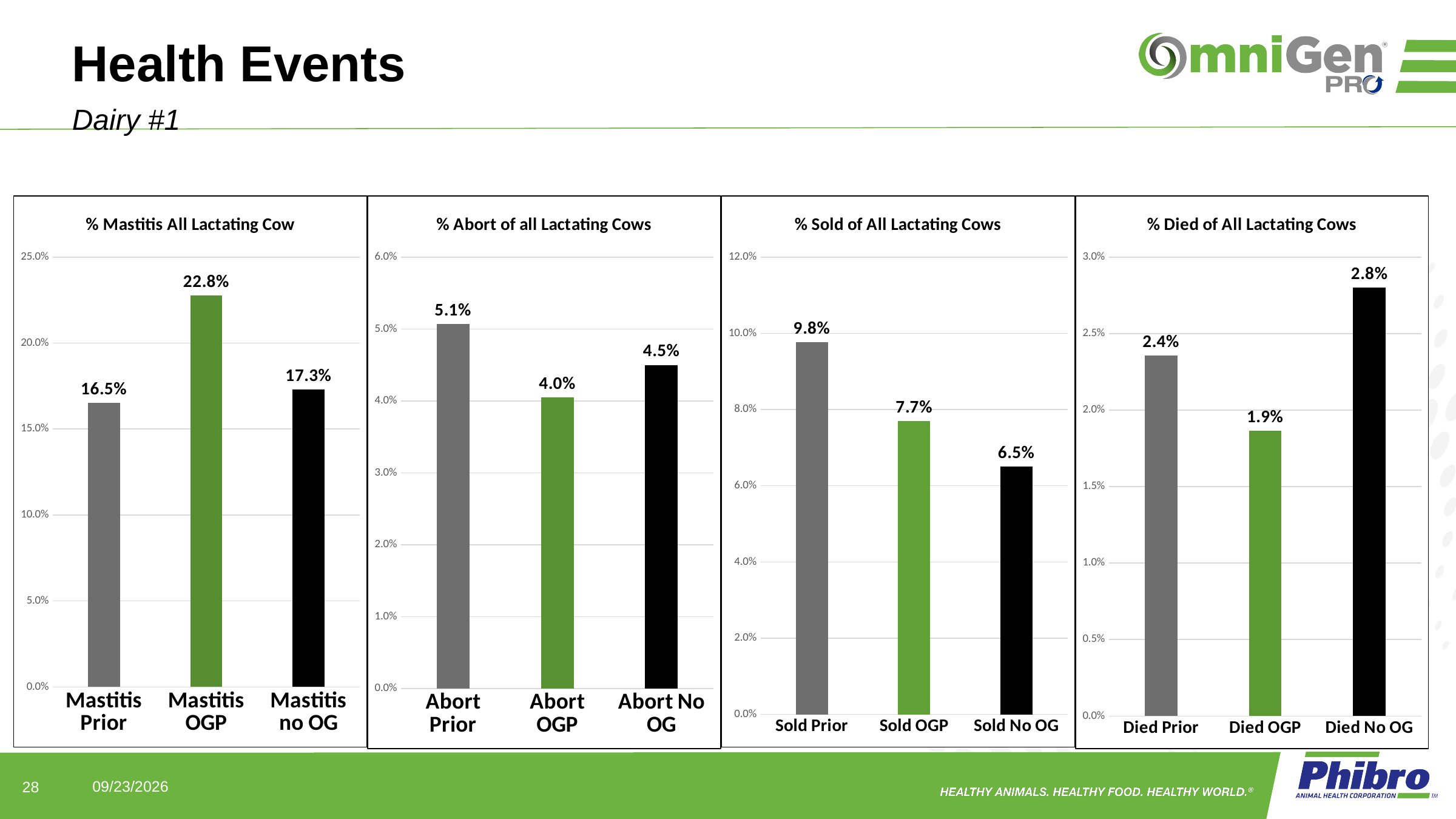
What type of chart is the '% Mastitis All Lactating Cow' chart? bar chart In the '% Abort of all Lactating Cows' chart, which category has the highest value? Abort Prior How many bars are in the '% Died of All Lactating Cows' chart? 3 In the '% Sold of All Lactating Cows' chart, is the value for Sold Prior greater or less than 8.0%? greater In the '% Mastitis All Lactating Cow' chart, which category has the lowest value? Mastitis Prior In the '% Sold of All Lactating Cows' chart, what is the value for Sold OGP? 7.7% In the '% Mastitis All Lactating Cow' chart, what is the value for Mastitis OGP? 22.8% In the '% Abort of all Lactating Cows' chart, what is the difference between Abort Prior and Abort OGP? 1.1% In the '% Sold of All Lactating Cows' chart, do the values rise or fall from left to right? fall In the '% Abort of all Lactating Cows' chart, what is the value for Abort No OG? 4.5% In the '% Died of All Lactating Cows' chart, which is larger, Died Prior or Died OGP? Died Prior In the '% Died of All Lactating Cows' chart, which category has the highest value? Died No OG